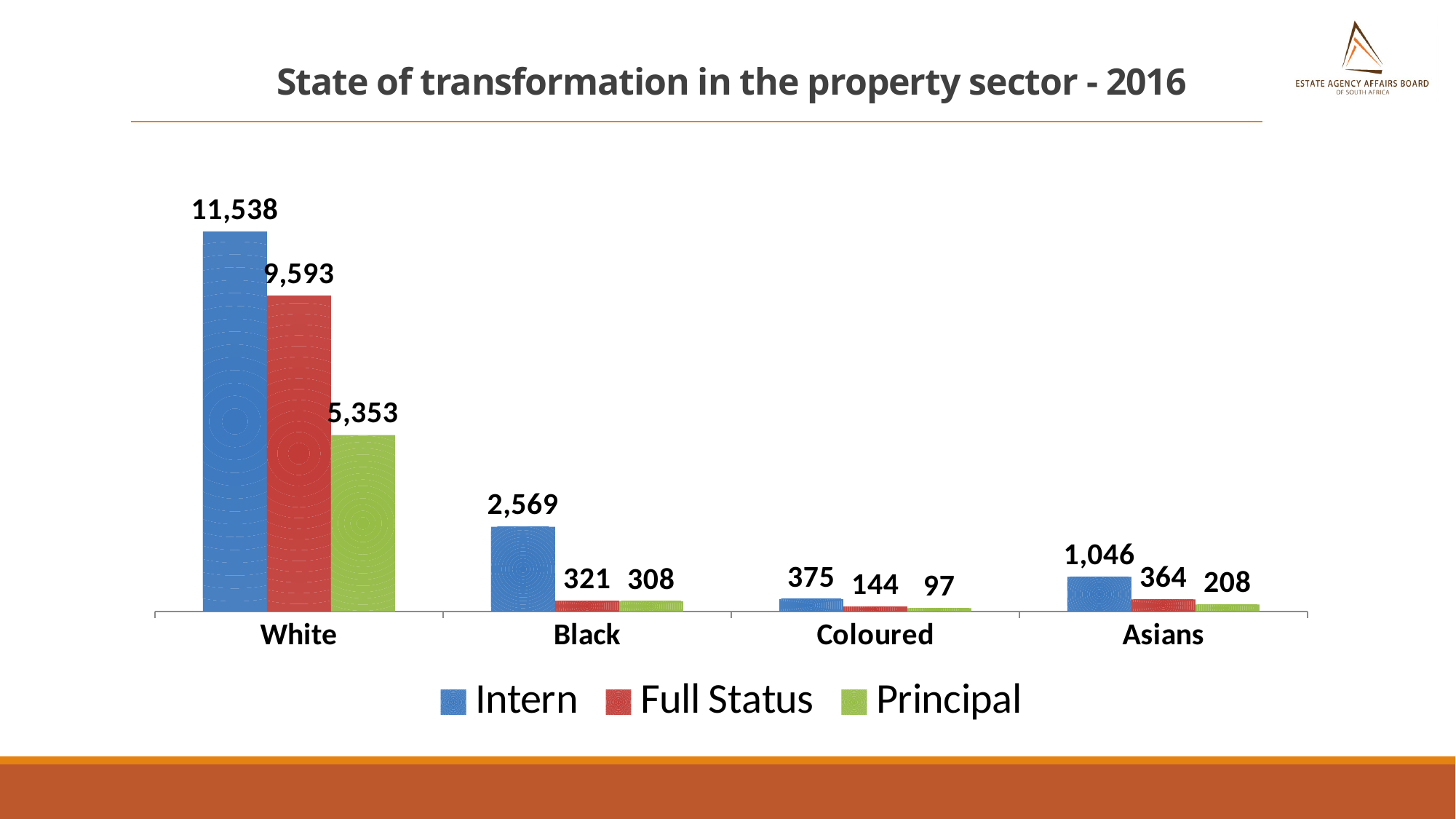
Which category has the highest Principal value? White What is the Principal value for Coloured? 97 How many series does the legend list? 3 Which category has the lowest Intern value? Coloured What is the Intern value for Asians? 1,046 Which colour represents the Principal series in the legend? Green What is the Full Status value for Black? 321 What is the Intern value for White? 11,538 What is the difference between the Intern and Full Status values for White? 1,945 What kind of chart is shown on the slide? Bar chart Which is larger, the Full Status value for Asians or the Full Status value for Black? Asians How many categories are shown on the x axis? 4